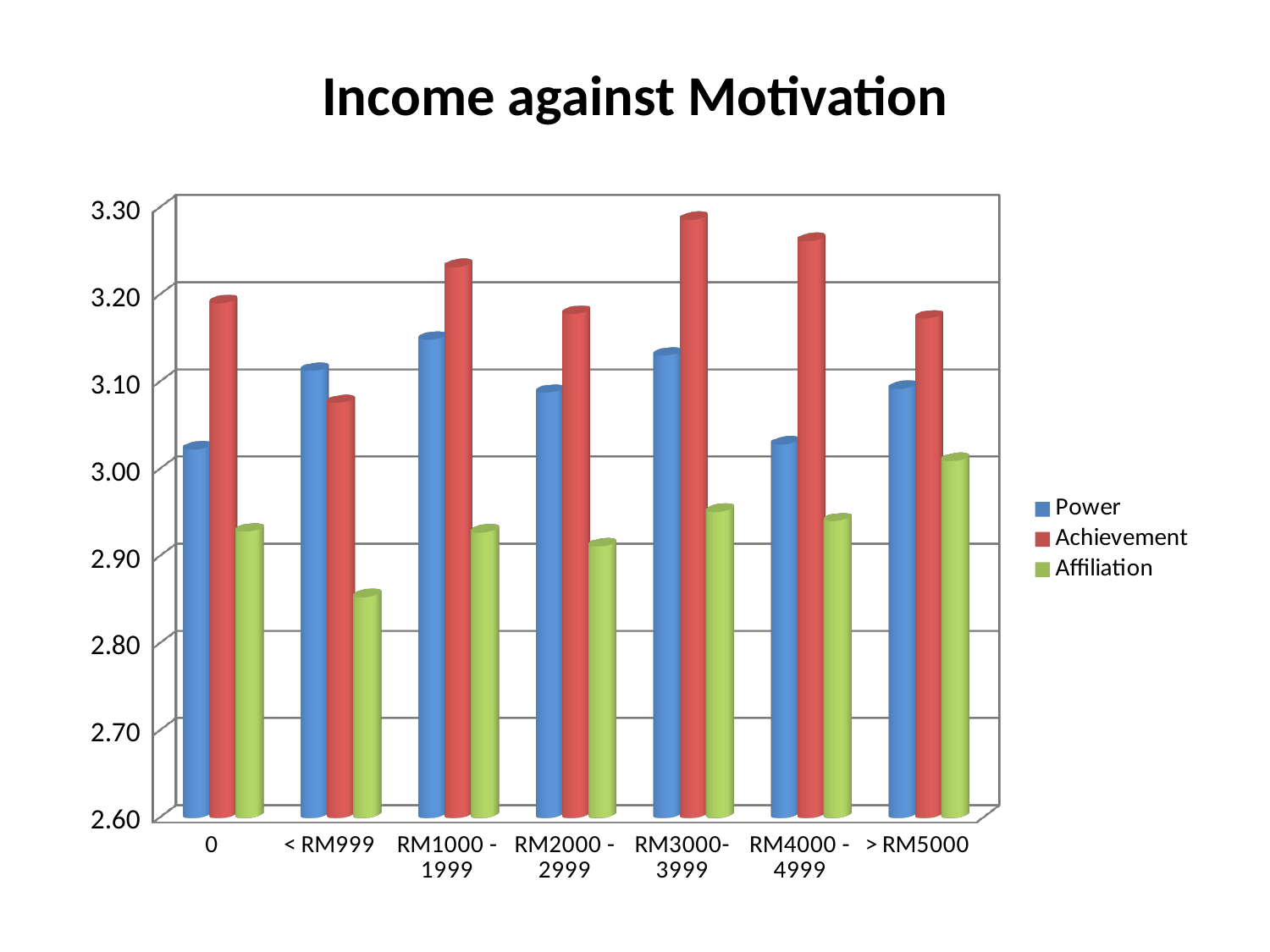
How many income categories are shown on the x axis? 7 Which income category has the lowest Affiliation value? < RM999 Which income category has the highest Affiliation value? > RM5000 Is the Affiliation value for < RM999 greater or less than 2.90? less Which income category has the lowest Achievement value? < RM999 Is the Achievement value for the 0 income category greater or less than 3.10? greater What type of chart is shown on the slide? Bar chart How many series does the legend list? 3 For the > RM5000 category, which is larger: Power or Affiliation? Power What is the title of the chart? Income against Motivation For the < RM999 category, which is larger: Power or Achievement? Power Is the Achievement value for RM3000-3999 greater or less than 3.20? greater